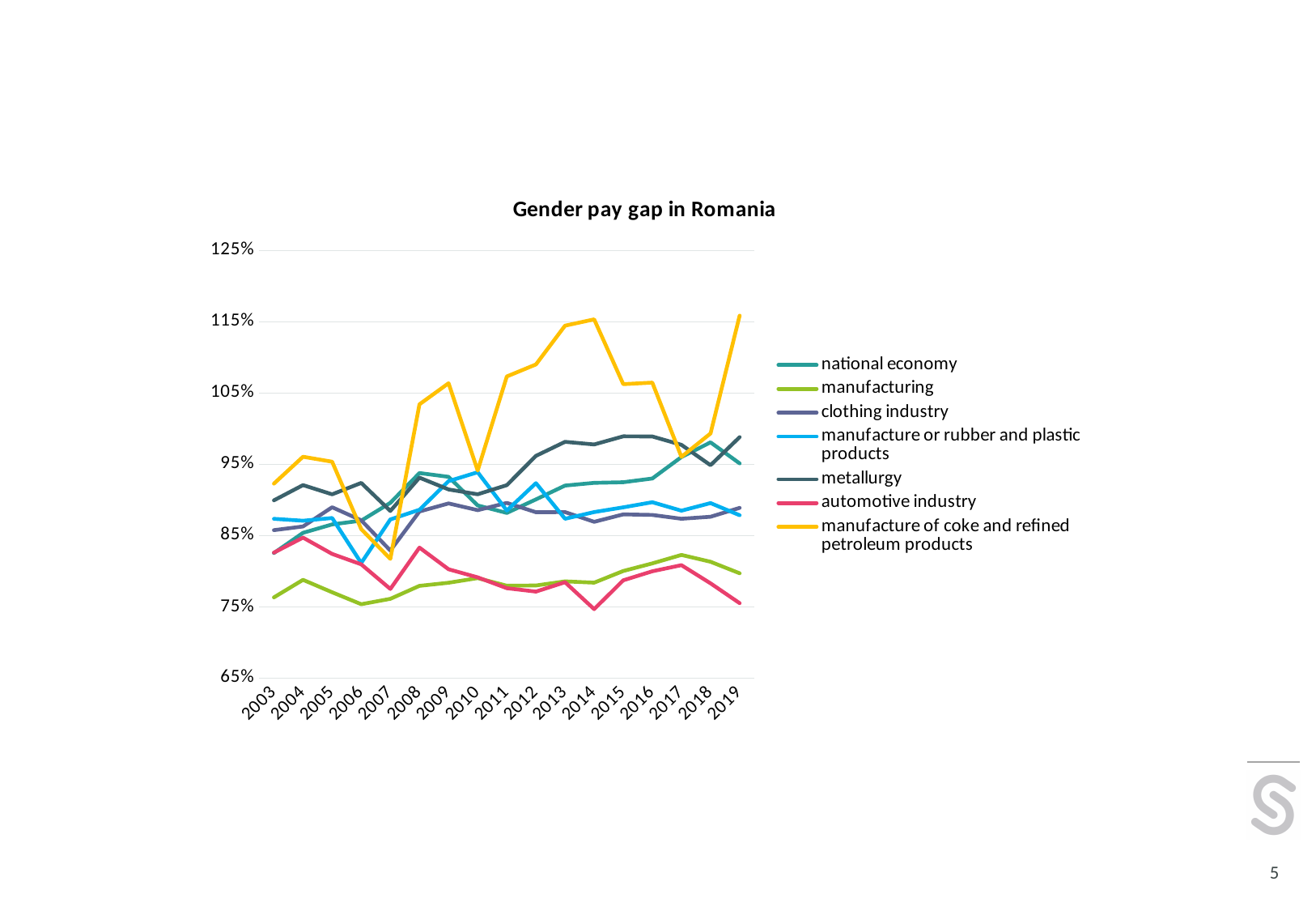
In 2019, which is larger: metallurgy or national economy? metallurgy How many series does the legend list? 7 How many years are shown along the x axis? 17 Is the value for automotive industry in 2014 greater or less than 85%? less Does the automotive industry line rise or fall from 2017 to 2019? fall What kind of chart is shown on the slide? line chart Which series has the highest value in 2019? manufacture of coke and refined petroleum products Which series has the lowest value in 2014? automotive industry Is the value for manufacture of coke and refined petroleum products in 2019 greater or less than 105%? greater Is the value for metallurgy in 2016 greater or less than 95%? greater What colour is the line for manufacture of coke and refined petroleum products? yellow What is the title of the chart? Gender pay gap in Romania